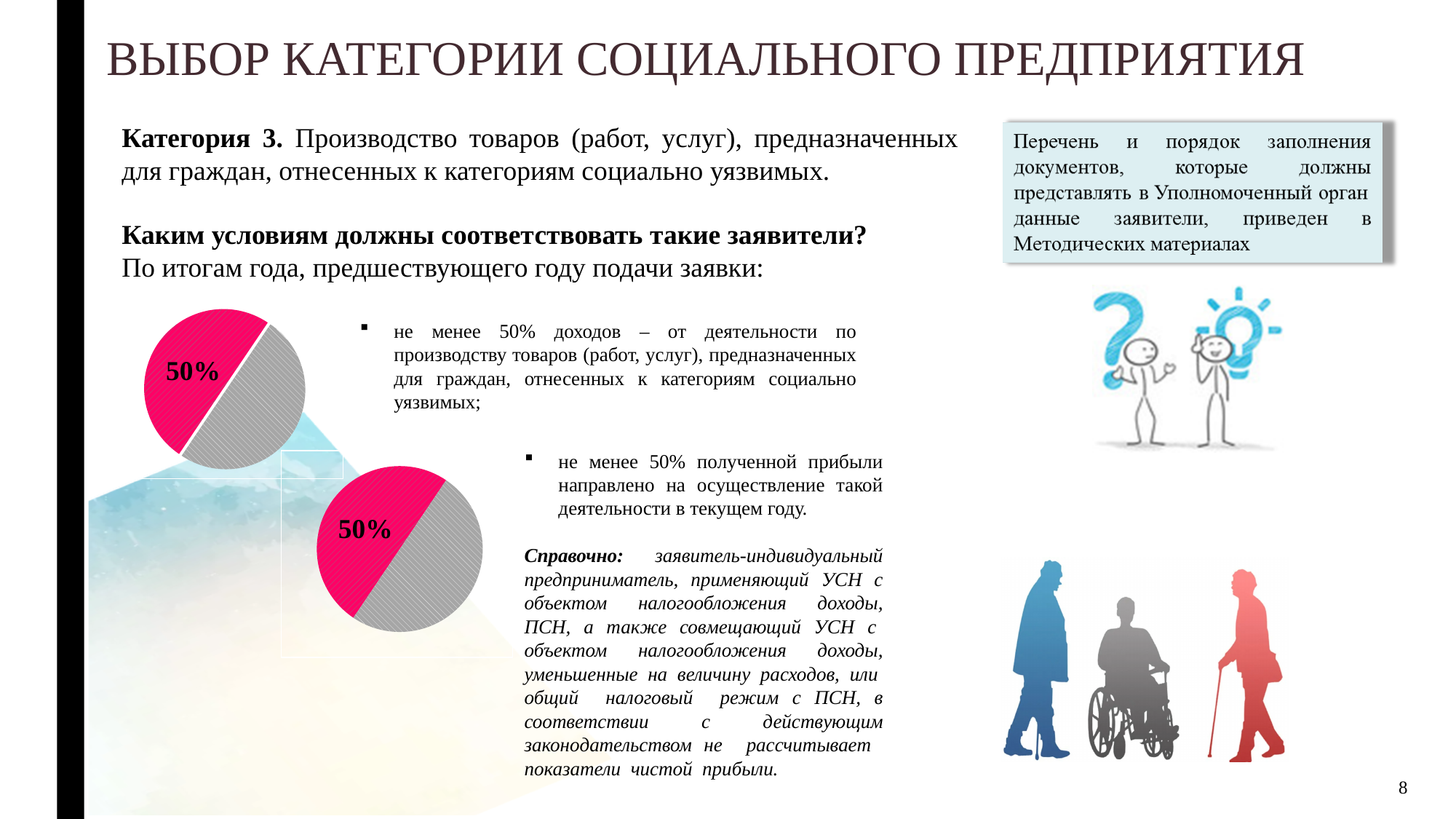
What kind of chart is the upper pie on the left side of the slide? pie chart What kind of chart is the lower pie on the left side of the slide? pie chart In the lower pie chart, is the pink slice larger than, smaller than, or equal to the grey slice? equal In the upper pie chart, is the pink slice larger than, smaller than, or equal to the grey slice? equal In the upper pie chart, what share is shown by the labelled pink slice? 50% How many pie charts are shown on the slide? 2 In the lower pie chart, what share is shown by the labelled pink slice? 50% How many slices does the lower pie chart have? 2 How many slices does the upper pie chart have? 2 What colour is the labelled 50% slice in the upper pie chart? pink